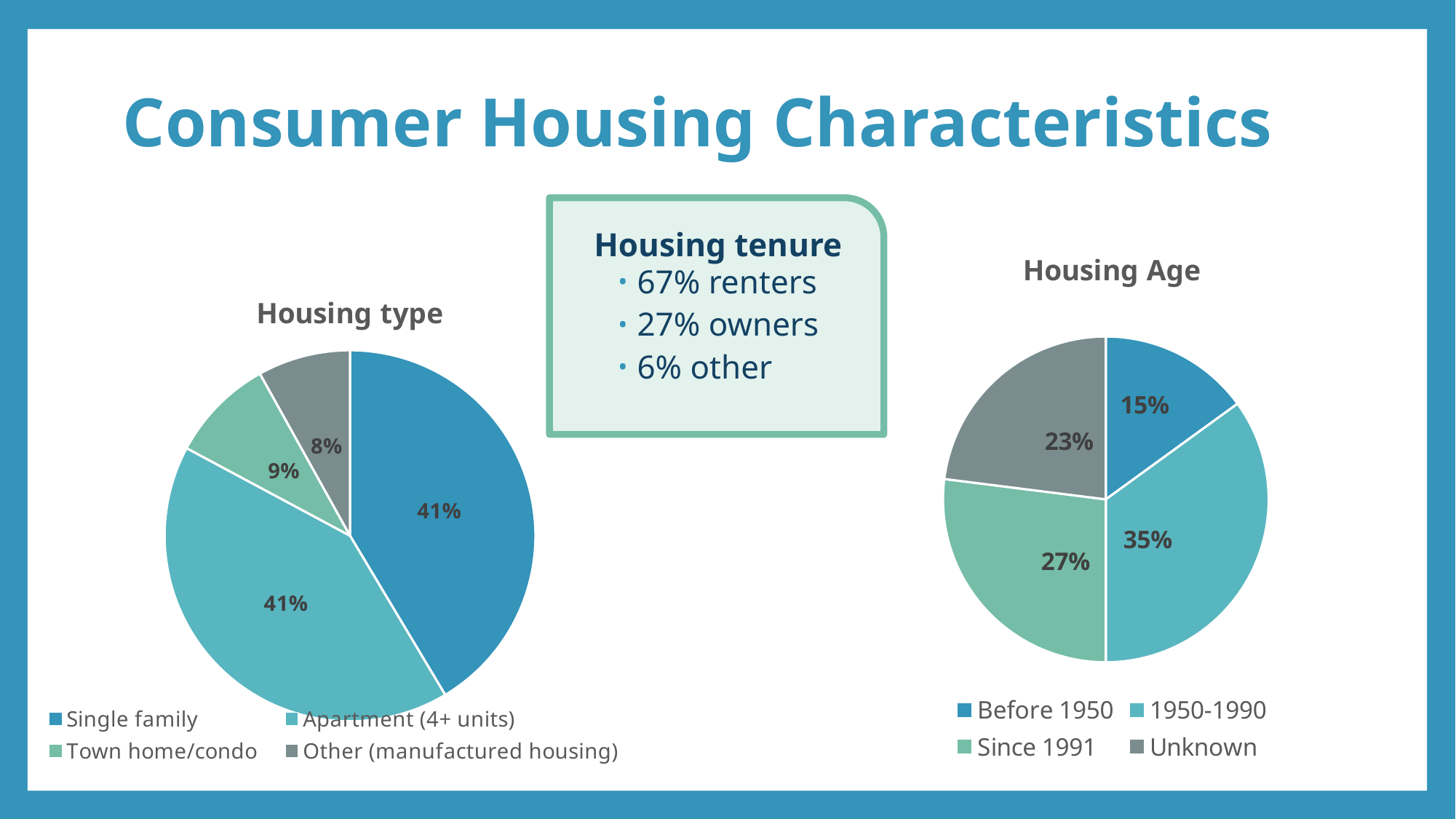
In the Housing type chart, how many categories does the legend list? 4 In the Housing Age chart, what share is Before 1950? 15% In the Housing Age chart, which category has the largest share? 1950-1990 In the Housing type chart, what share is Other (manufactured housing)? 8% In the Housing Age chart, what share is Since 1991? 27% In the Housing Age chart, what is the difference between the 1950-1990 share and the Unknown share? 12% In the Housing type chart, what share is Town home/condo? 9% What kind of chart is the Housing type chart? Pie chart In the Housing type chart, what share is Single family? 41% In the Housing type chart, which category has the smallest share? Other (manufactured housing) In the Housing Age chart, which category has the smallest share? Before 1950 In the Housing Age chart, which is larger, Since 1991 or Unknown? Since 1991